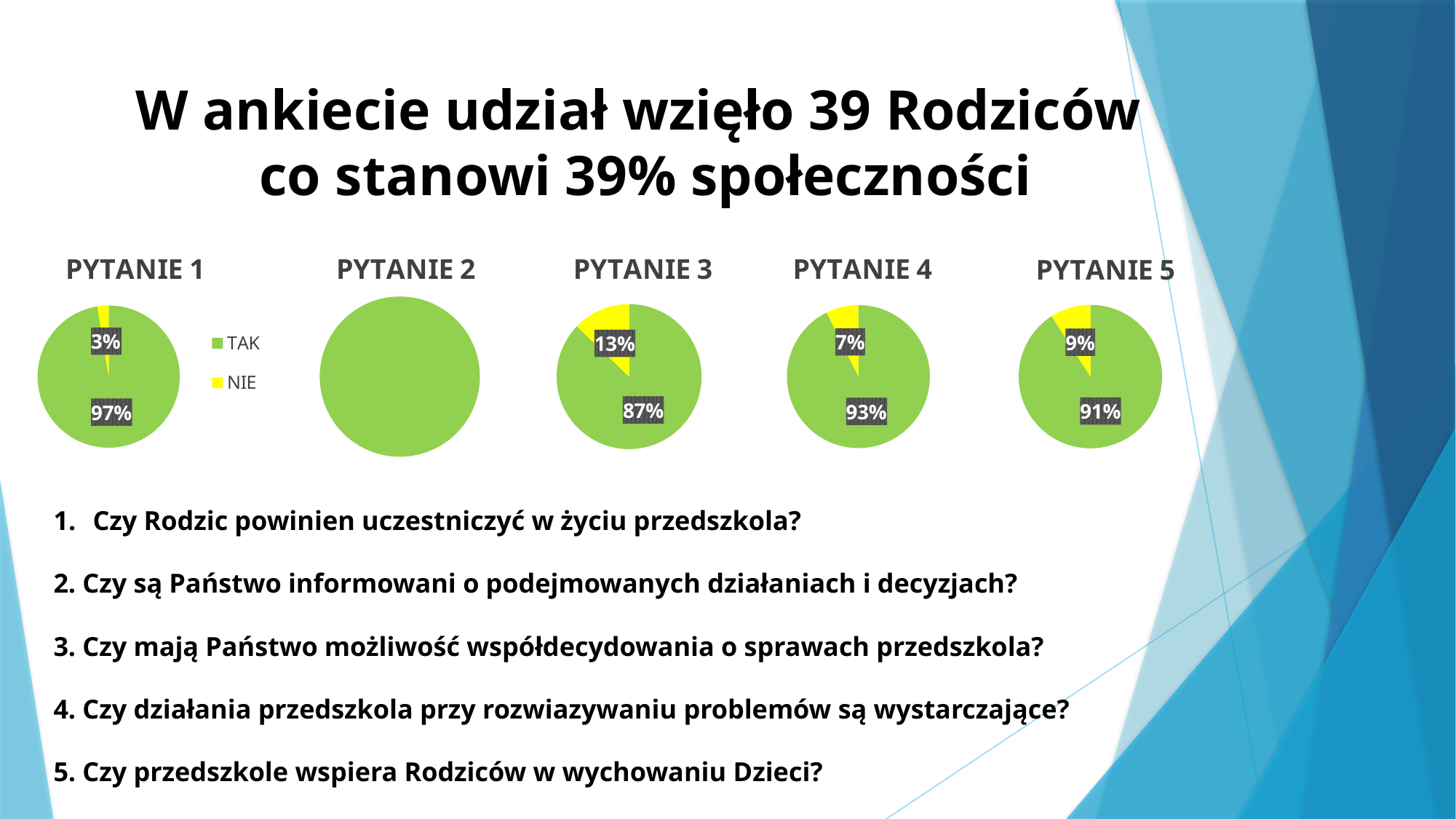
In the PYTANIE 5 chart, what percentage is shown for NIE? 9% What kind of chart is used for PYTANIE 1? pie chart In the PYTANIE 1 chart, what is the difference in percentage points between the TAK and NIE slices? 94 In the PYTANIE 3 chart, which slice is larger, TAK or NIE? TAK In the PYTANIE 1 chart, what percentage is shown for NIE? 3% How many pie charts are shown on the slide? 5 In the PYTANIE 4 chart, what percentage is shown for the green (TAK) slice? 93% In the PYTANIE 1 chart, what percentage is shown for TAK? 97% How many series does the legend next to the PYTANIE 1 chart list? 2 In the PYTANIE 3 chart, what percentage is shown for the yellow (NIE) slice? 13% Among the charts with printed labels, which PYTANIE chart has the largest NIE share? PYTANIE 3 Which colour represents TAK in the legend? green